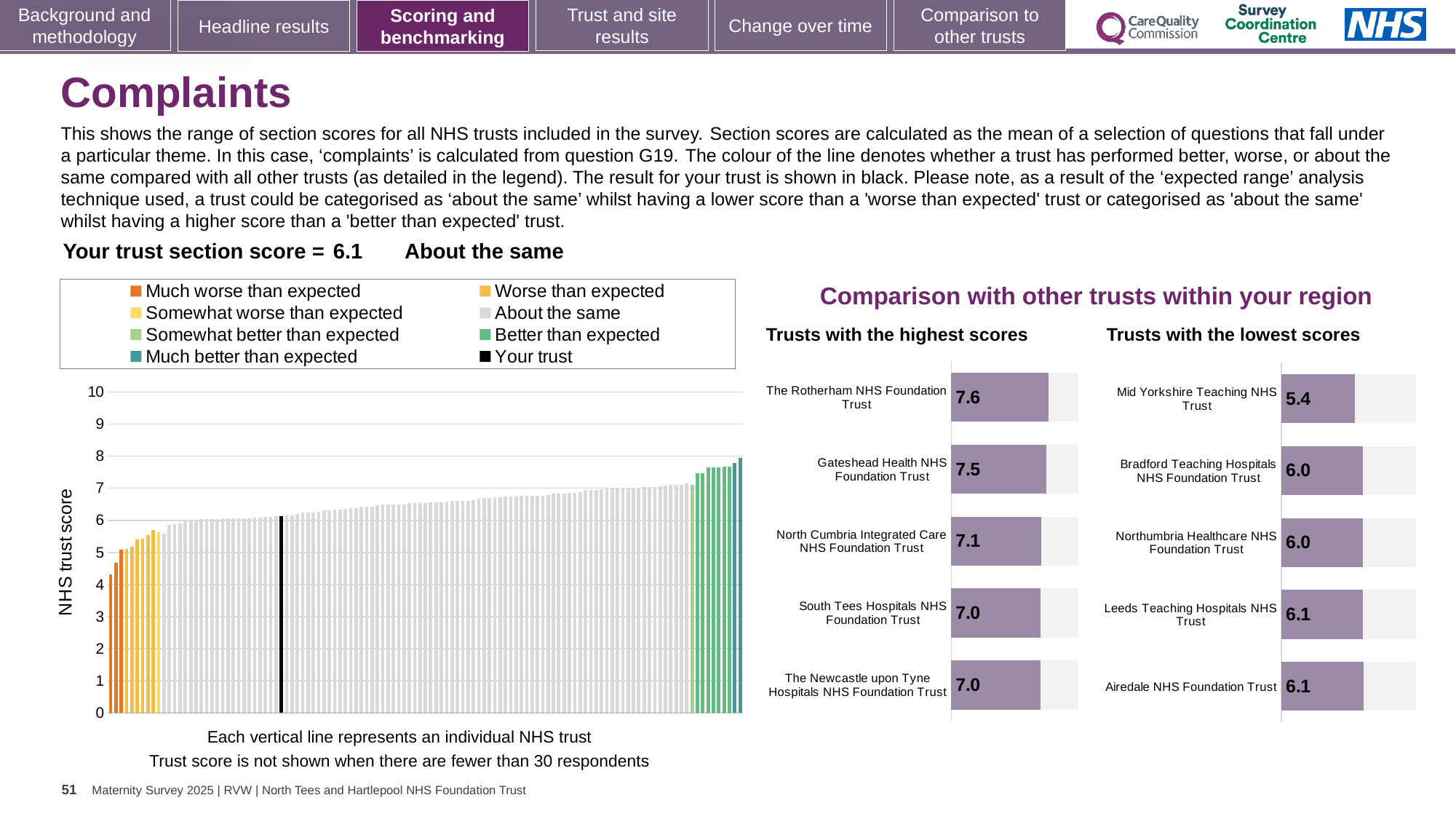
In the 'Trusts with the lowest scores' chart, which trust has the lowest score? Mid Yorkshire Teaching NHS Trust How many entries does the legend of the 'NHS trust score' chart on the left list? 8 How many trusts are listed in the 'Trusts with the lowest scores' chart? 5 In the 'NHS trust score' chart on the left, is the value of the black bar (your trust) greater or less than 5? greater What is the difference between The Rotherham NHS Foundation Trust's score in the 'Trusts with the highest scores' chart and Mid Yorkshire Teaching NHS Trust's score in the 'Trusts with the lowest scores' chart? 2.2 In the 'Trusts with the lowest scores' chart, what is the score for Mid Yorkshire Teaching NHS Trust? 5.4 In the 'NHS trust score' chart on the left, do the bar values rise or fall from left to right? Rise In the 'Trusts with the highest scores' chart, which has the larger score: Gateshead Health NHS Foundation Trust or North Cumbria Integrated Care NHS Foundation Trust? Gateshead Health NHS Foundation Trust In the 'Trusts with the highest scores' chart, what is the score for The Rotherham NHS Foundation Trust? 7.6 In the 'Trusts with the highest scores' chart, which trust has the highest score? The Rotherham NHS Foundation Trust In the 'Trusts with the highest scores' chart, what is the score for South Tees Hospitals NHS Foundation Trust? 7.0 What kind of chart is the 'NHS trust score' chart on the left of the slide? Bar chart